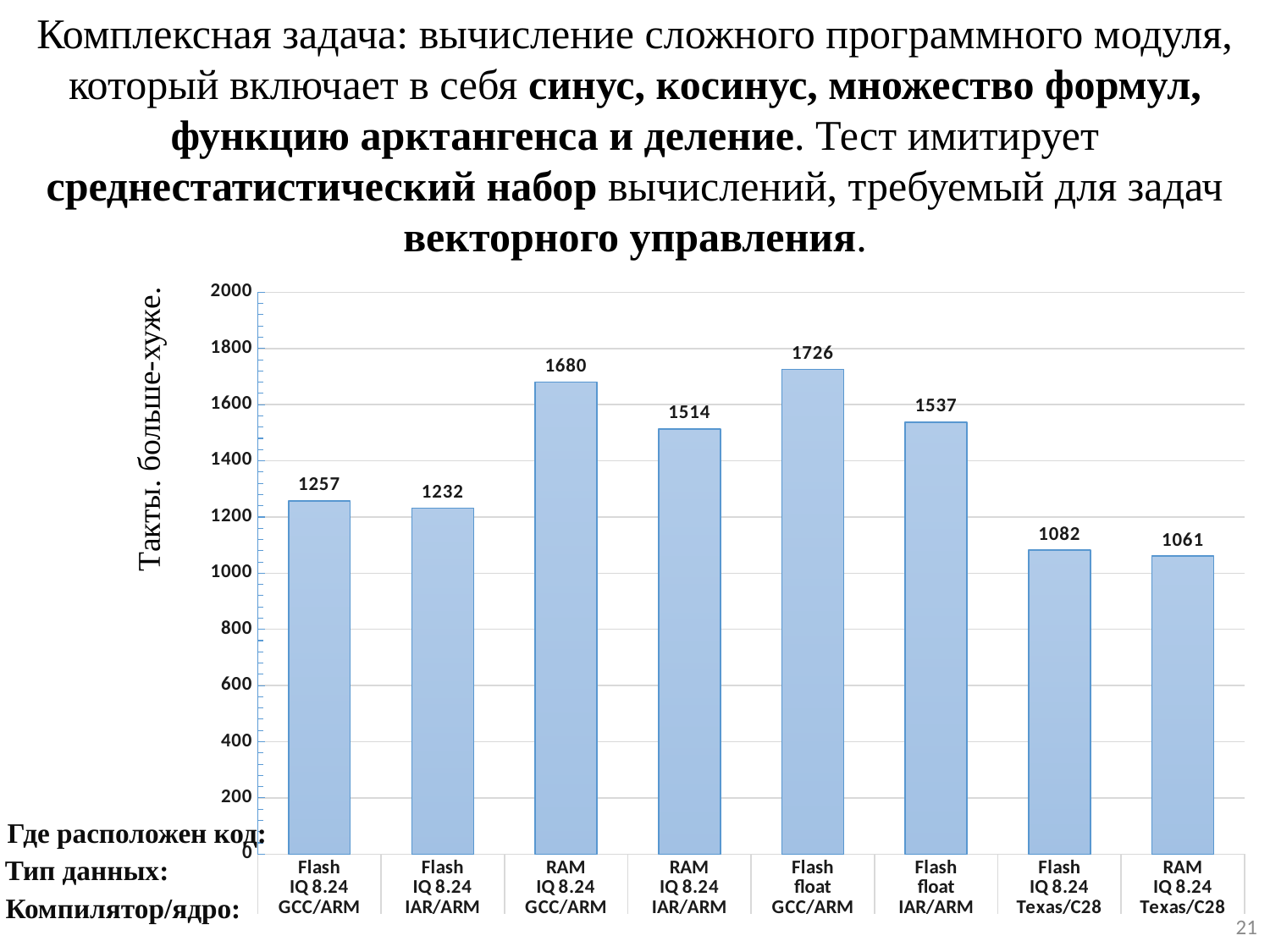
What is the value for the bar labelled RAM, IQ 8.24, IAR/ARM? 1514 Which category has the lowest value? RAM, IQ 8.24, Texas/C28 Which is larger: the value for Flash, IQ 8.24, GCC/ARM or the value for Flash, IQ 8.24, IAR/ARM? Flash, IQ 8.24, GCC/ARM What is the value for the bar labelled Flash, IQ 8.24, GCC/ARM? 1257 Is the value for Flash, IQ 8.24, Texas/C28 greater or less than 1200? less What kind of chart is shown on the slide? bar chart How many bars are shown in the chart? 8 What is the difference between the values for RAM, IQ 8.24, GCC/ARM and RAM, IQ 8.24, IAR/ARM? 166 What is the value for the bar labelled RAM, IQ 8.24, Texas/C28? 1061 What is the value for the bar labelled Flash, float, IAR/ARM? 1537 What is the label of the vertical axis? Такты. больше-хуже. Which category has the highest value? Flash, float, GCC/ARM